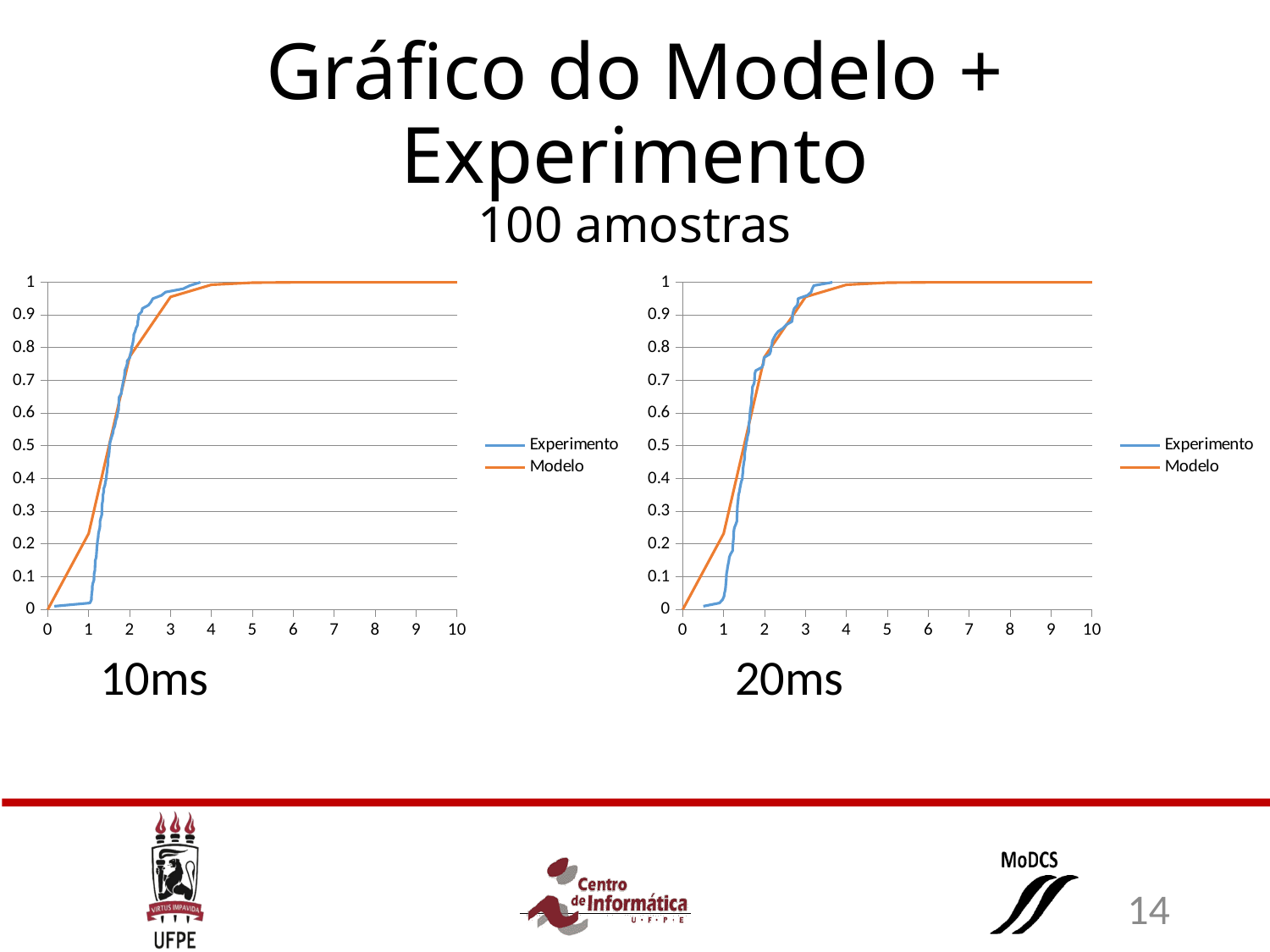
In the right chart labelled 20ms, do the values of the Modelo series rise or fall along the x axis? rise How many series does the legend of the right chart labelled 20ms list? 2 What kind of chart is the left chart labelled 10ms? line chart What is the highest value shown on the x axis of the right chart labelled 20ms? 10 In the left chart labelled 10ms, at x = 1, which series has the higher value, Experimento or Modelo? Modelo In the left chart labelled 10ms, do the values of the Experimento series rise or fall as x increases from 0 to 10? rise In the right chart labelled 20ms, is the value of the Experimento series at x = 1 greater or less than 0.1? less In the right chart labelled 20ms, at x = 1, which series has the higher value, Experimento or Modelo? Modelo In the left chart labelled 10ms, what are the two series named in the legend? Experimento and Modelo In the left chart labelled 10ms, is the value of the Modelo series at x = 1 greater or less than 0.2? greater In the left chart labelled 10ms, is the value of the Experimento series at x = 2 greater or less than 0.5? greater In the right chart labelled 20ms, which colour is used for the Modelo series? orange